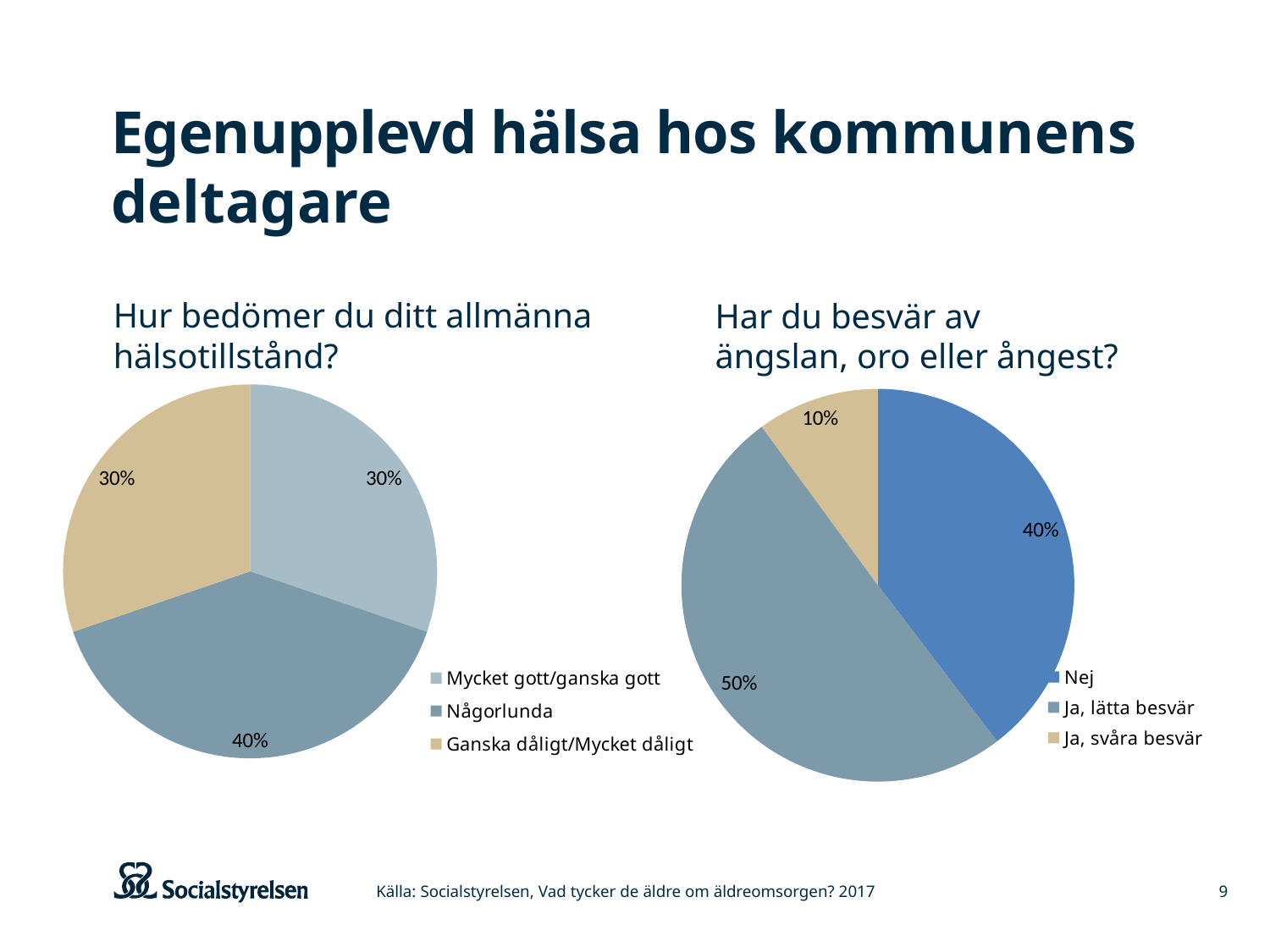
In the right chart 'Har du besvär av ängslan, oro eller ångest?', what share is labelled for Ja, lätta besvär? 50% What kind of chart is the left chart 'Hur bedömer du ditt allmänna hälsotillstånd?'? Pie chart In the right chart 'Har du besvär av ängslan, oro eller ångest?', what is the difference between the shares for Ja, lätta besvär and Ja, svåra besvär? 40% In the left chart 'Hur bedömer du ditt allmänna hälsotillstånd?', which category has the largest slice? Någorlunda In the right chart 'Har du besvär av ängslan, oro eller ångest?', what share is labelled for Nej? 40% In the left chart 'Hur bedömer du ditt allmänna hälsotillstånd?', how many categories does the legend list? 3 In the right chart 'Har du besvär av ängslan, oro eller ångest?', which category has the largest slice? Ja, lätta besvär In the right chart 'Har du besvär av ängslan, oro eller ångest?', which is larger: the share for Nej or the share for Ja, lätta besvär? Ja, lätta besvär In the left chart 'Hur bedömer du ditt allmänna hälsotillstånd?', what share is labelled for Någorlunda? 40% In the right chart 'Har du besvär av ängslan, oro eller ångest?', what colour is the slice for Nej? Blue In the right chart 'Har du besvär av ängslan, oro eller ångest?', which category has the smallest slice? Ja, svåra besvär In the left chart 'Hur bedömer du ditt allmänna hälsotillstånd?', what share is labelled for Mycket gott/ganska gott? 30%